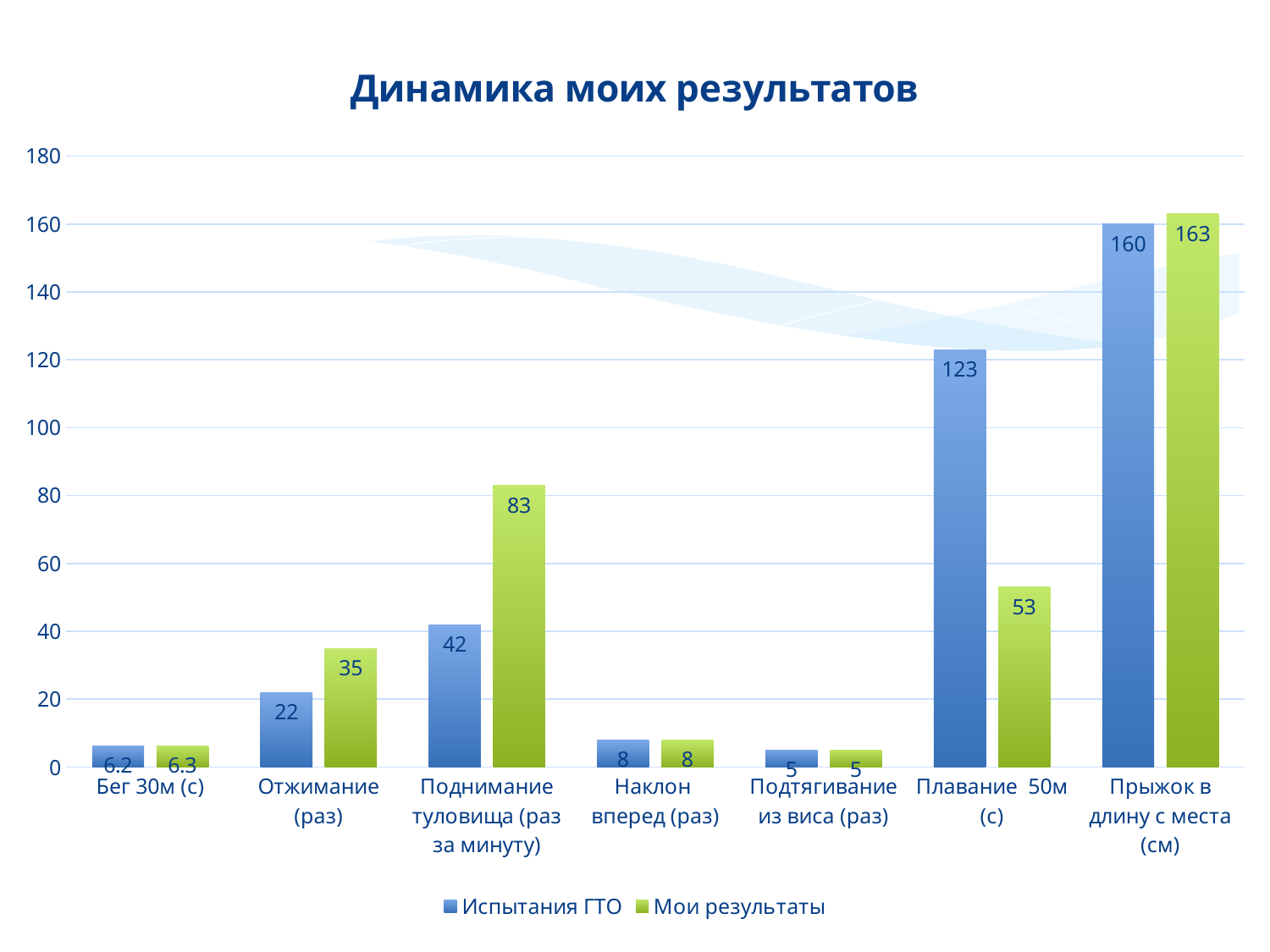
Is the value of "Испытания ГТО" for "Прыжок в длину с места (см)" greater or less than 140? greater What is the value of "Испытания ГТО" for "Плавание 50м (с)"? 123 What is the value of "Мои результаты" for "Бег 30м (с)"? 6.3 For "Плавание 50м (с)", which series has the larger value: "Испытания ГТО" or "Мои результаты"? Испытания ГТО What kind of chart is shown on the slide? bar chart What is the title of the chart? Динамика моих результатов Which category has the highest value in the "Мои результаты" series? Прыжок в длину с места (см) Which category has the lowest value in the "Испытания ГТО" series? Подтягивание из виса (раз) What is the value of "Мои результаты" for "Поднимание туловища (раз за минуту)"? 83 How many categories are shown on the x axis? 7 What is the difference between "Мои результаты" and "Испытания ГТО" for "Отжимание (раз)"? 13 How many series does the legend list? 2